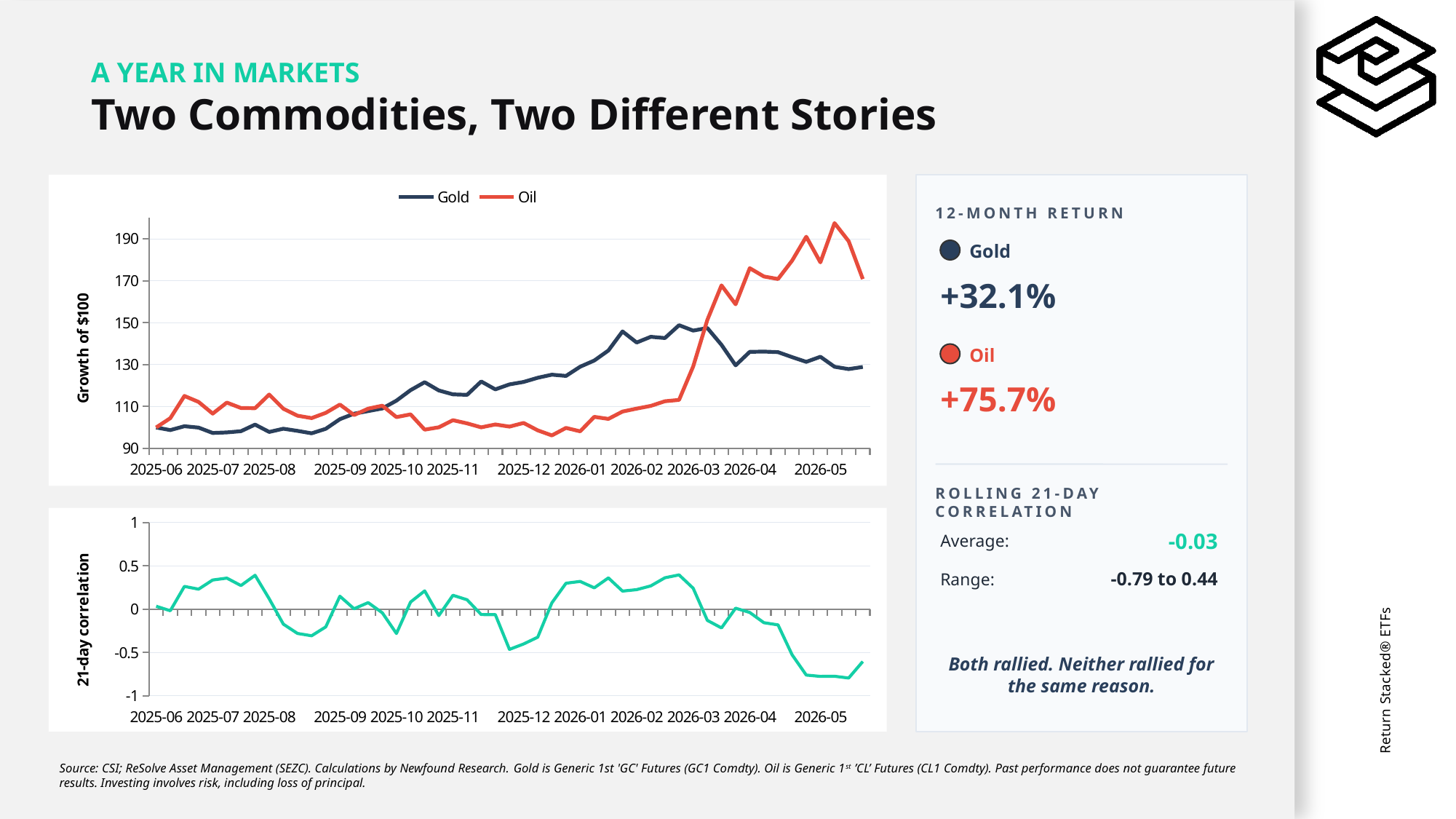
What are the two series named in the legend of the top chart? Gold and Oil What kind of chart is the top chart on the slide? line chart According to the 12-month return panel, what is the return for Gold? +32.1% In the top chart, is the peak value of the Oil line greater or less than 190? greater What is the y-axis label of the bottom chart? 21-day correlation In the bottom chart, does the correlation rise or fall between 2026-04 and 2026-05? fall In the top chart, is the final value of the Gold line greater or less than 150? less How many series does the legend of the top chart list? 2 In the top chart, which line is higher at the end of the period, Gold or Oil? Oil According to the 12-month return panel, what is the return for Oil? +75.7% In the top chart, is the final value of the Oil line greater or less than 150? greater